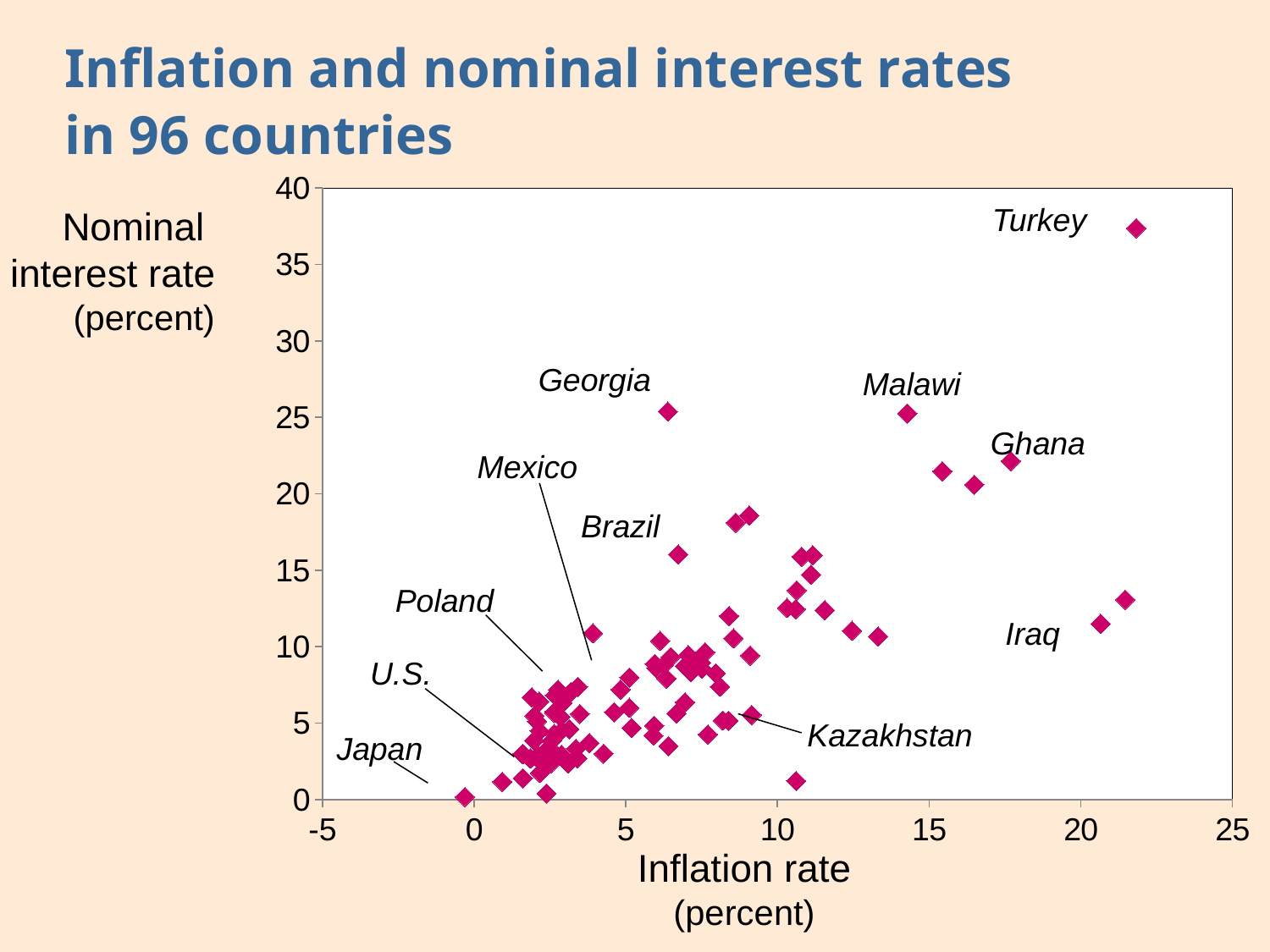
Overall, does the nominal interest rate tend to rise or fall as the inflation rate increases along the x axis? Rise Is the nominal interest rate for Turkey greater or less than 35? greater Which labeled country has the highest nominal interest rate in the chart? Turkey Which has the higher nominal interest rate, Georgia or Brazil? Georgia Is the inflation rate for Ghana greater or less than 15? greater What kind of chart is shown on the slide? Scatter plot Which has the higher inflation rate, Japan or the U.S.? U.S. What variable is plotted on the x axis of the chart? Inflation rate (percent) What is the title of the chart on the slide? Inflation and nominal interest rates in 96 countries Is the nominal interest rate for Malawi greater or less than 20? greater Which labeled country has the lowest nominal interest rate in the chart? Japan